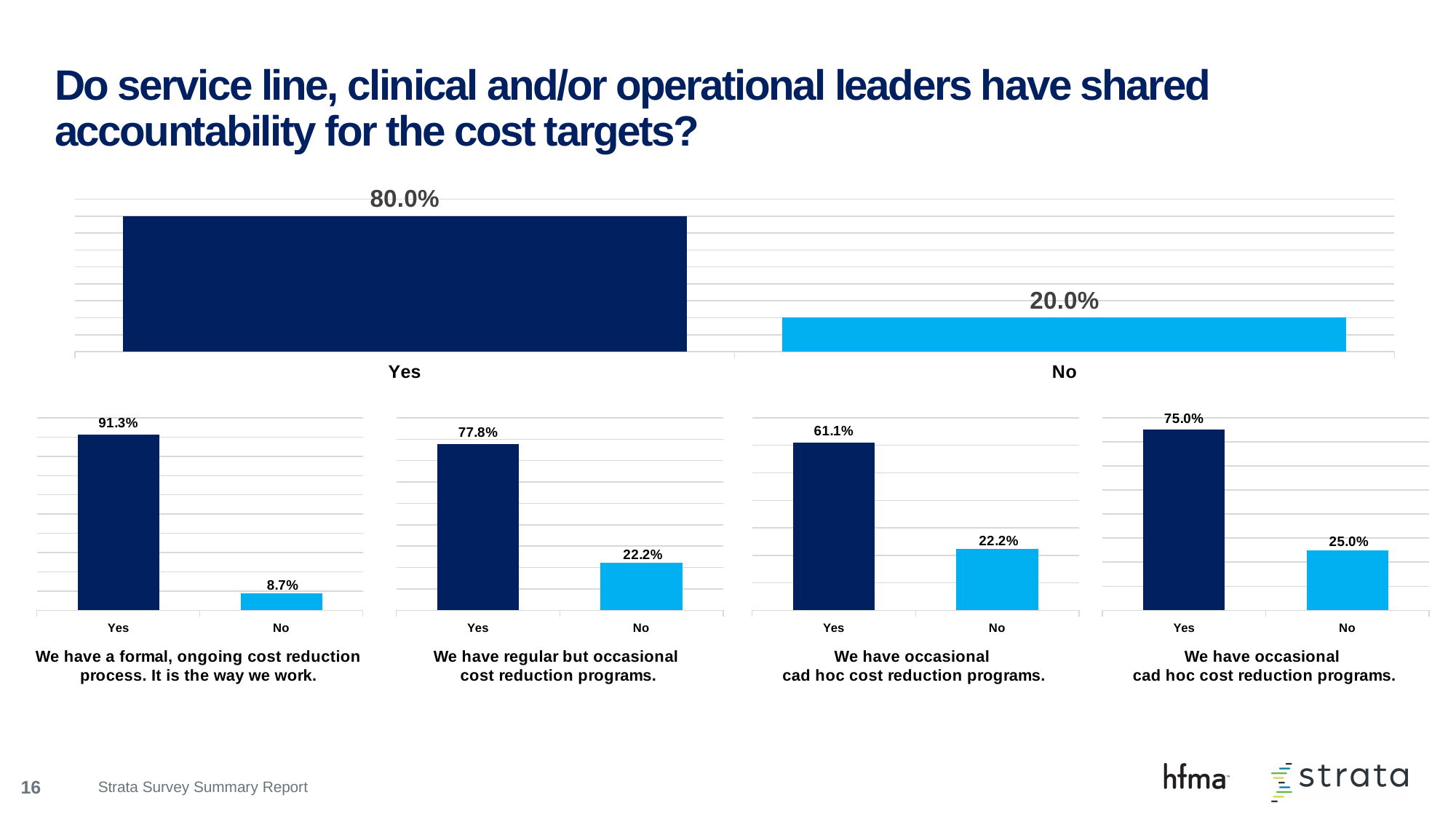
In the large chart at the top of the slide, what is the value for Yes? 80.0% What kind of chart is the large chart at the top of the slide? Bar chart In the small chart captioned 'We have a formal, ongoing cost reduction process. It is the way we work.', what is the value for Yes? 91.3% In the large chart at the top of the slide, which category is higher, Yes or No? Yes Across the four small charts in the bottom row, which chart has the lowest Yes value? The third from the left (61.1%) In the large chart at the top of the slide, what is the value for No? 20.0% In the rightmost small chart in the bottom row, what is the value for No? 25.0% In the small chart captioned 'We have regular but occasional cost reduction programs.', what is the difference between the Yes and No values? 55.6% In the large chart at the top of the slide, what is the difference between the Yes and No values? 60.0% In the small chart captioned 'We have regular but occasional cost reduction programs.', what is the value for No? 22.2% In the small chart captioned 'We have a formal, ongoing cost reduction process. It is the way we work.', what is the value for No? 8.7% In the third small chart from the left in the bottom row, what is the value for Yes? 61.1%